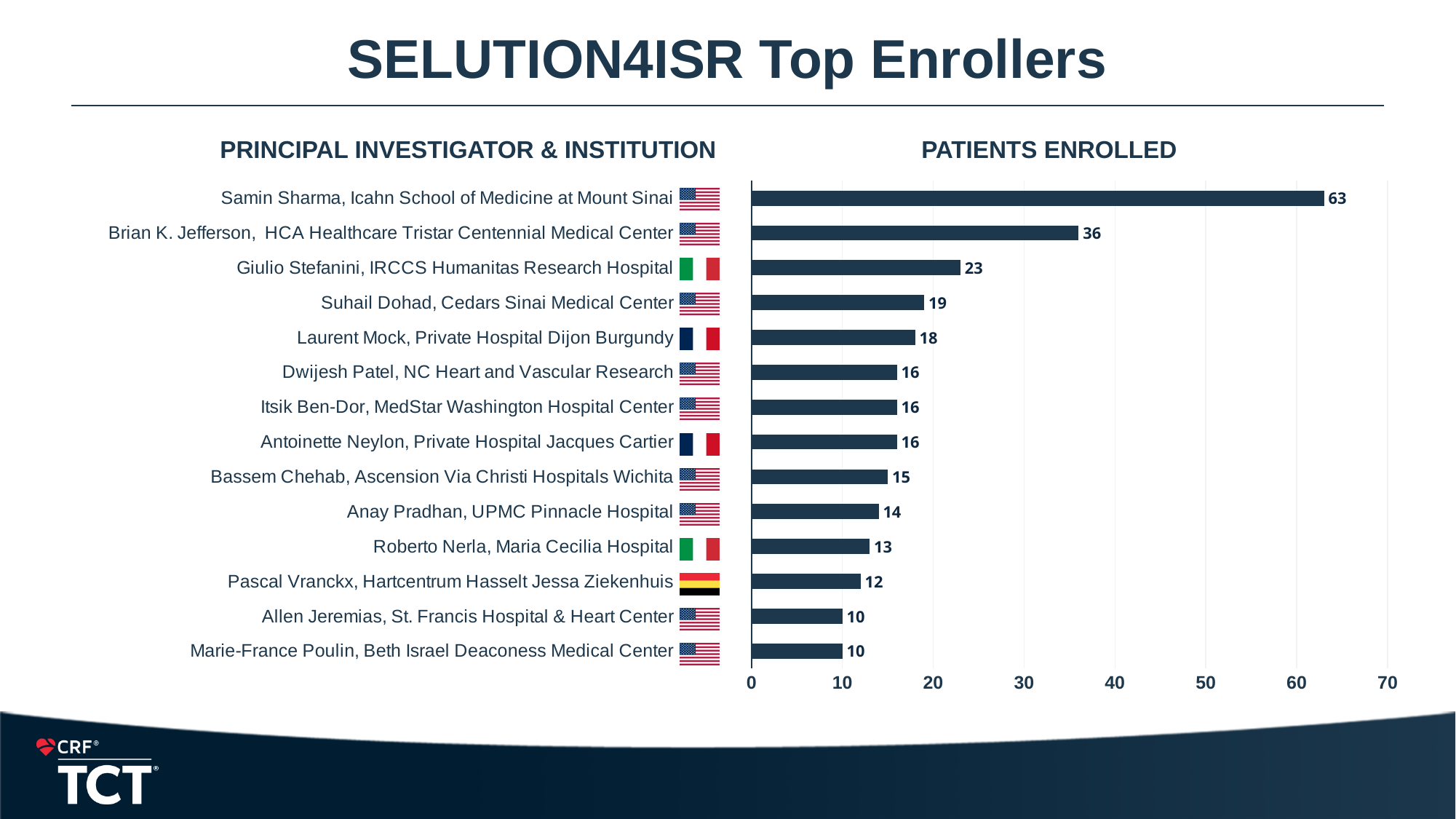
How many principal investigators are listed in the chart? 14 Is the value for Brian K. Jefferson greater or less than 30? greater What is the difference in patients enrolled between Samin Sharma and Brian K. Jefferson? 27 How many patients did Pascal Vranckx, Hartcentrum Hasselt Jessa Ziekenhuis enroll? 12 What is the highest value shown on the horizontal axis? 70 Which principal investigator enrolled the most patients? Samin Sharma, Icahn School of Medicine at Mount Sinai How many patients did Samin Sharma, Icahn School of Medicine at Mount Sinai enroll? 63 How many patients did Giulio Stefanini, IRCCS Humanitas Research Hospital enroll? 23 Who enrolled more patients, Laurent Mock or Anay Pradhan? Laurent Mock What kind of chart is shown on the slide? Bar chart What is the title of the slide? SELUTION4ISR Top Enrollers What is the difference in patients enrolled between Suhail Dohad and Roberto Nerla? 6